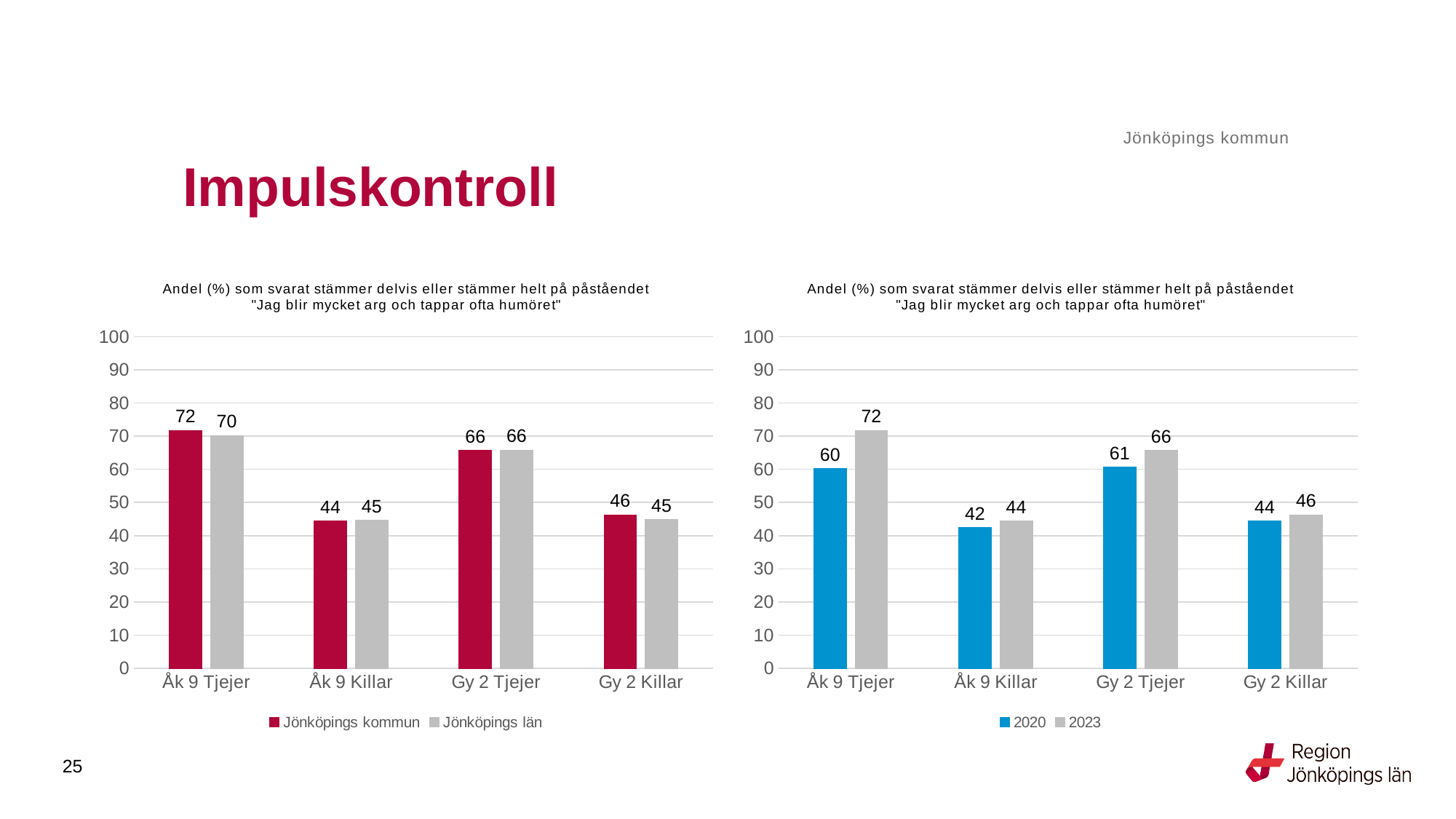
In the right chart, what is the difference between the 2023 and 2020 values for Åk 9 Tjejer? 12 How many categories are shown on the x axis of the left chart? 4 How many series does the legend of the right chart list? 2 In the right chart, which is larger for Gy 2 Killar: the 2020 value or the 2023 value? 2023 In the right chart, which category has the highest value for 2023? Åk 9 Tjejer What kind of chart is the left chart? Bar chart In the left chart, which category has the lowest value for Jönköpings kommun? Åk 9 Killar In the left chart, what is the value for Jönköpings kommun for Åk 9 Tjejer? 72 In the left chart, what is the difference between the Jönköpings kommun and Jönköpings län values for Åk 9 Tjejer? 2 In the right chart, what is the value for 2023 for Åk 9 Killar? 44 In the left chart, what is the value for Jönköpings län for Gy 2 Killar? 45 In the right chart, what is the value for 2020 for Gy 2 Tjejer? 61